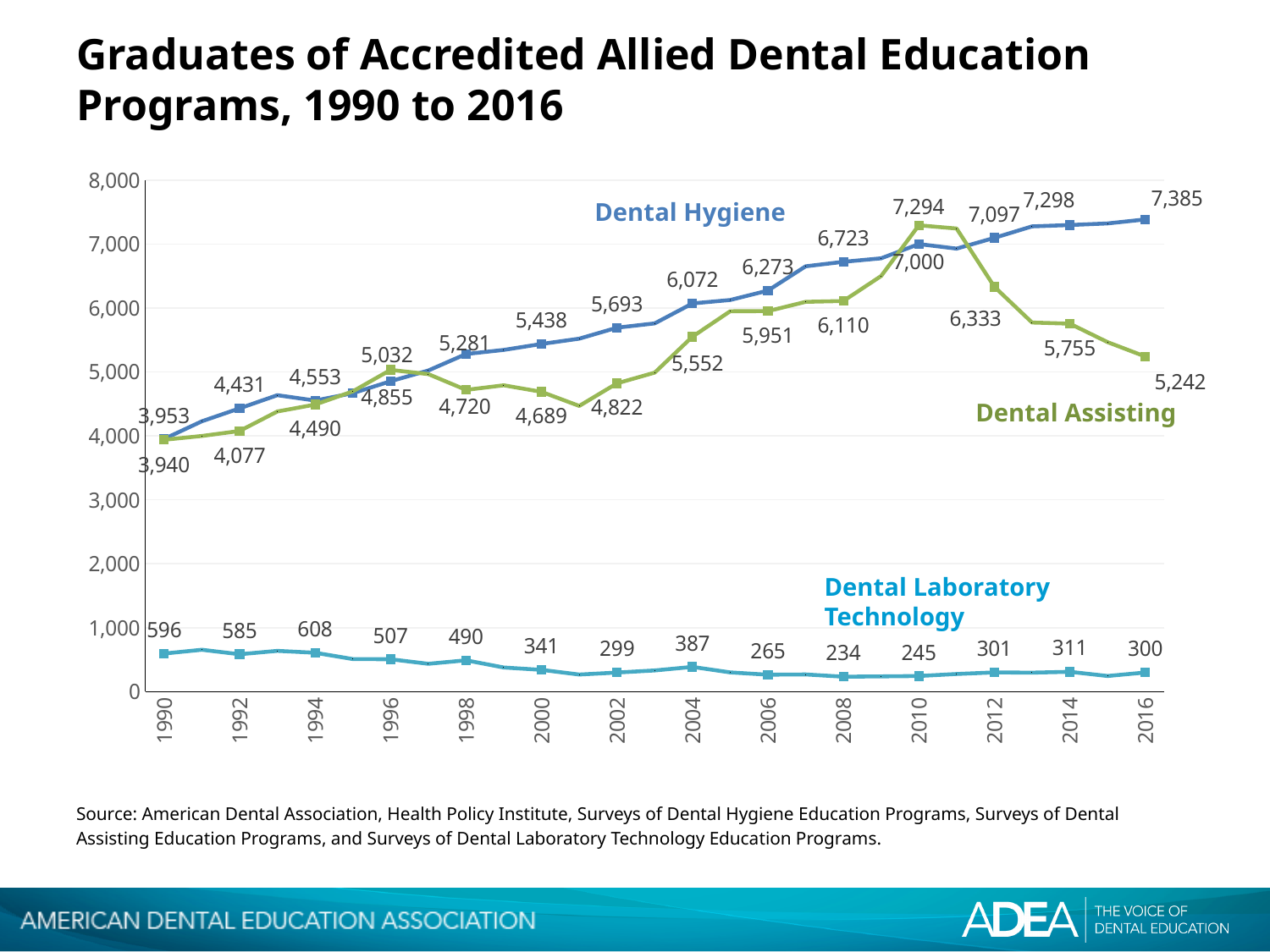
In which labeled year did Dental Assisting graduates reach their highest value? 2010 How many graduates of Dental Hygiene programs were there in 2016? 7,385 What type of chart is shown on the slide? Line chart How many series are plotted on the chart? 3 In which labeled year did Dental Laboratory Technology graduates reach their lowest value? 2008 What was the number of Dental Assisting graduates in 2010? 7,294 In 2010, which had more graduates: Dental Hygiene or Dental Assisting? Dental Assisting What is the difference between Dental Hygiene graduates and Dental Assisting graduates in 2016? 2,143 What was the number of Dental Hygiene graduates in 2004? 6,072 What is the title of the chart? Graduates of Accredited Allied Dental Education Programs, 1990 to 2016 How did the number of Dental Hygiene graduates change from 1990 to 2016? It rose What was the number of Dental Laboratory Technology graduates in 1990? 596